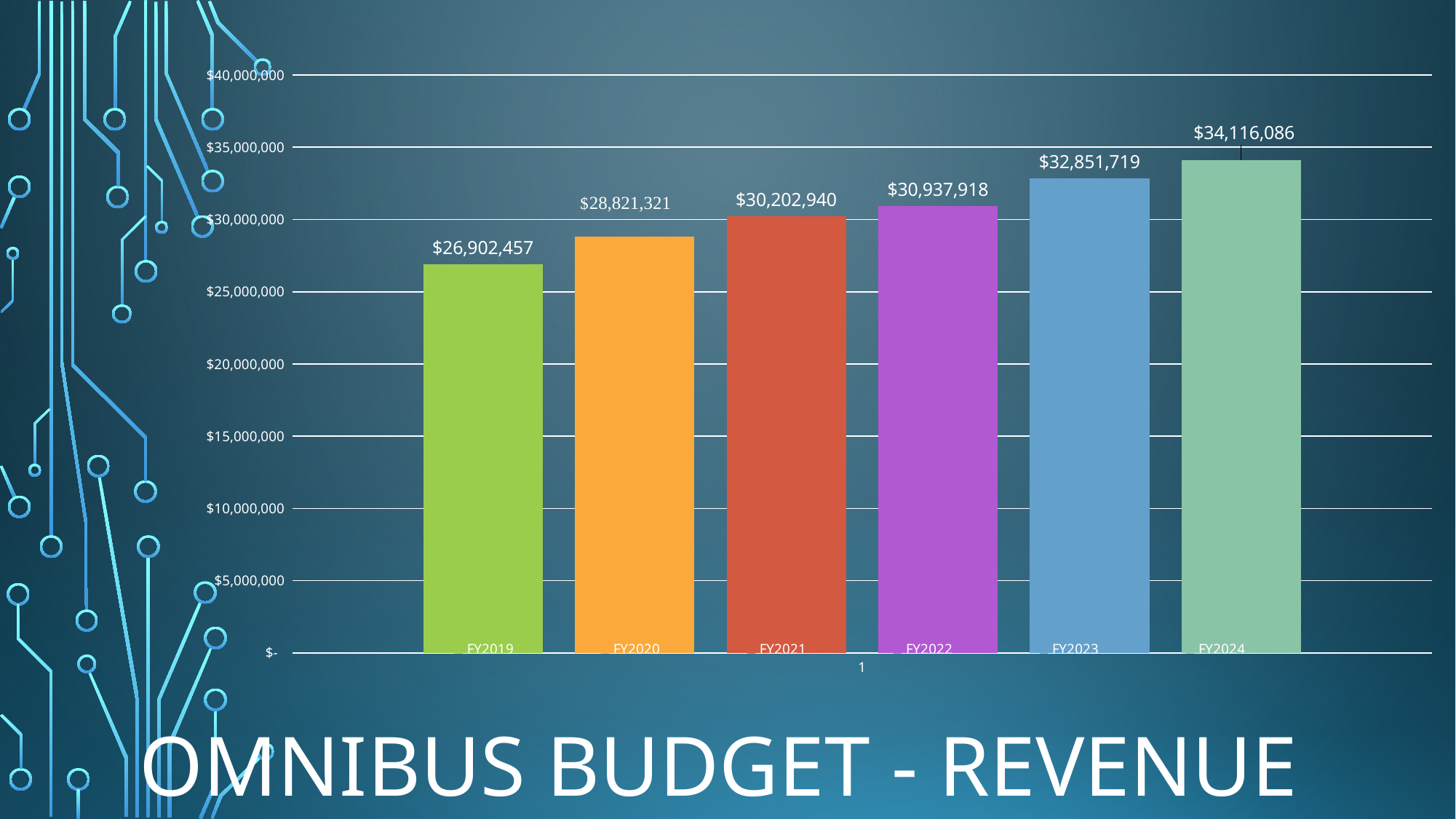
Do the revenue values rise or fall from FY2019 to FY2024? Rise What is the difference between the FY2024 and FY2019 revenue values? $7,213,629 What is the difference between the FY2023 and FY2022 revenue values? $1,913,801 Is the value for FY2023 greater or less than $30,000,000? greater What is the revenue value shown for FY2024? $34,116,086 Which fiscal year has the highest revenue? FY2024 Which fiscal year has the lowest revenue? FY2019 How many fiscal years are shown on the chart? 6 What kind of chart is shown on the slide? Bar chart What is the revenue value shown for FY2019? $26,902,457 Which is larger, the revenue for FY2021 or FY2020? FY2021 What is the revenue value shown for FY2022? $30,937,918